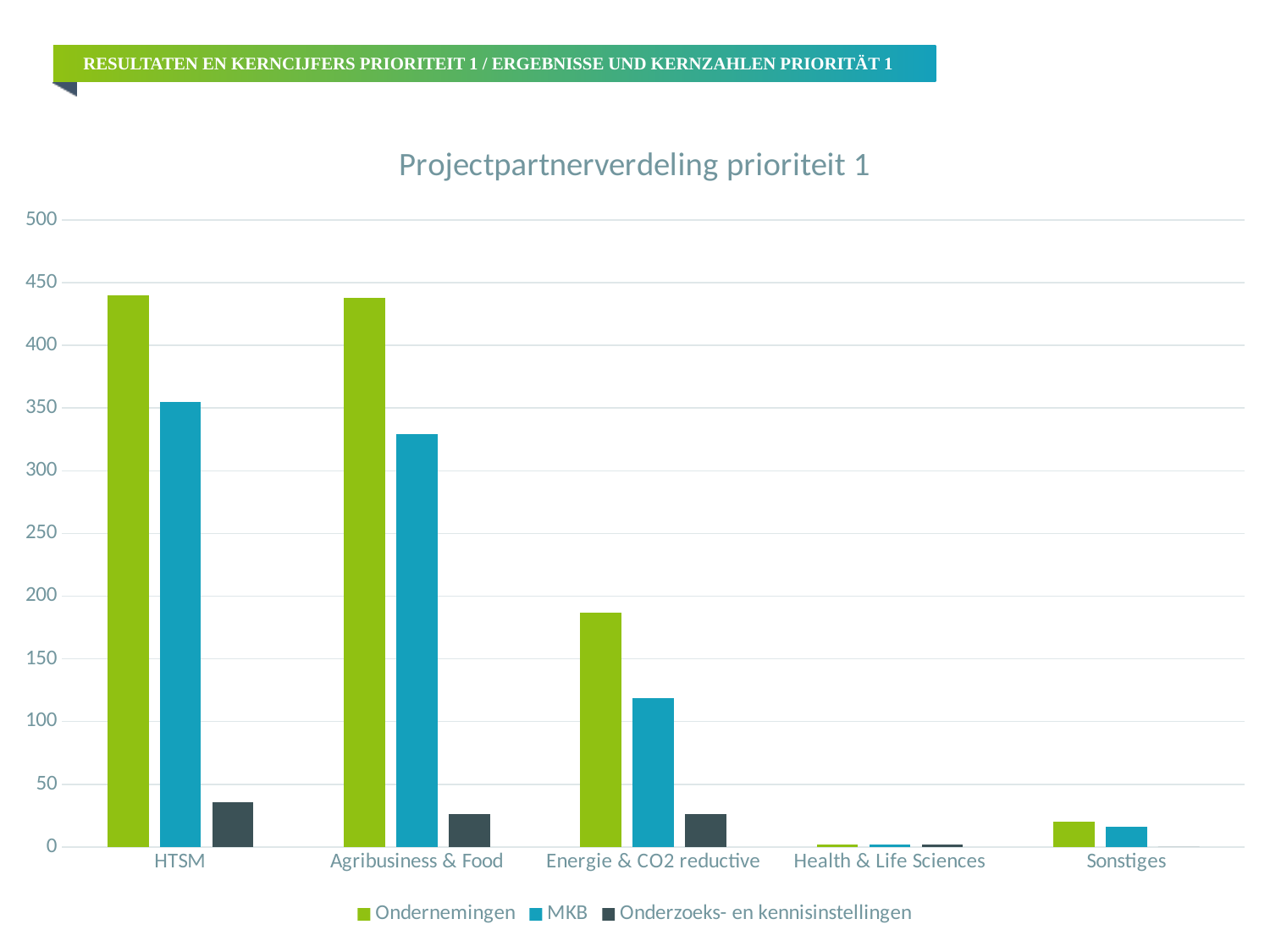
Is the Ondernemingen value for Energie & CO2 reductive greater or less than 200? less How many categories are shown on the x axis? 5 For Energie & CO2 reductive, which is larger: the Ondernemingen value or the MKB value? Ondernemingen What kind of chart is shown on the slide? bar chart Is the Ondernemingen value for Sonstiges greater or less than 50? less Which category has the lowest Ondernemingen value? Health & Life Sciences How many series does the legend list? 3 What is the title of the chart? Projectpartnerverdeling prioriteit 1 Is the Ondernemingen value for HTSM greater or less than 400? greater Which category has the highest MKB value? HTSM